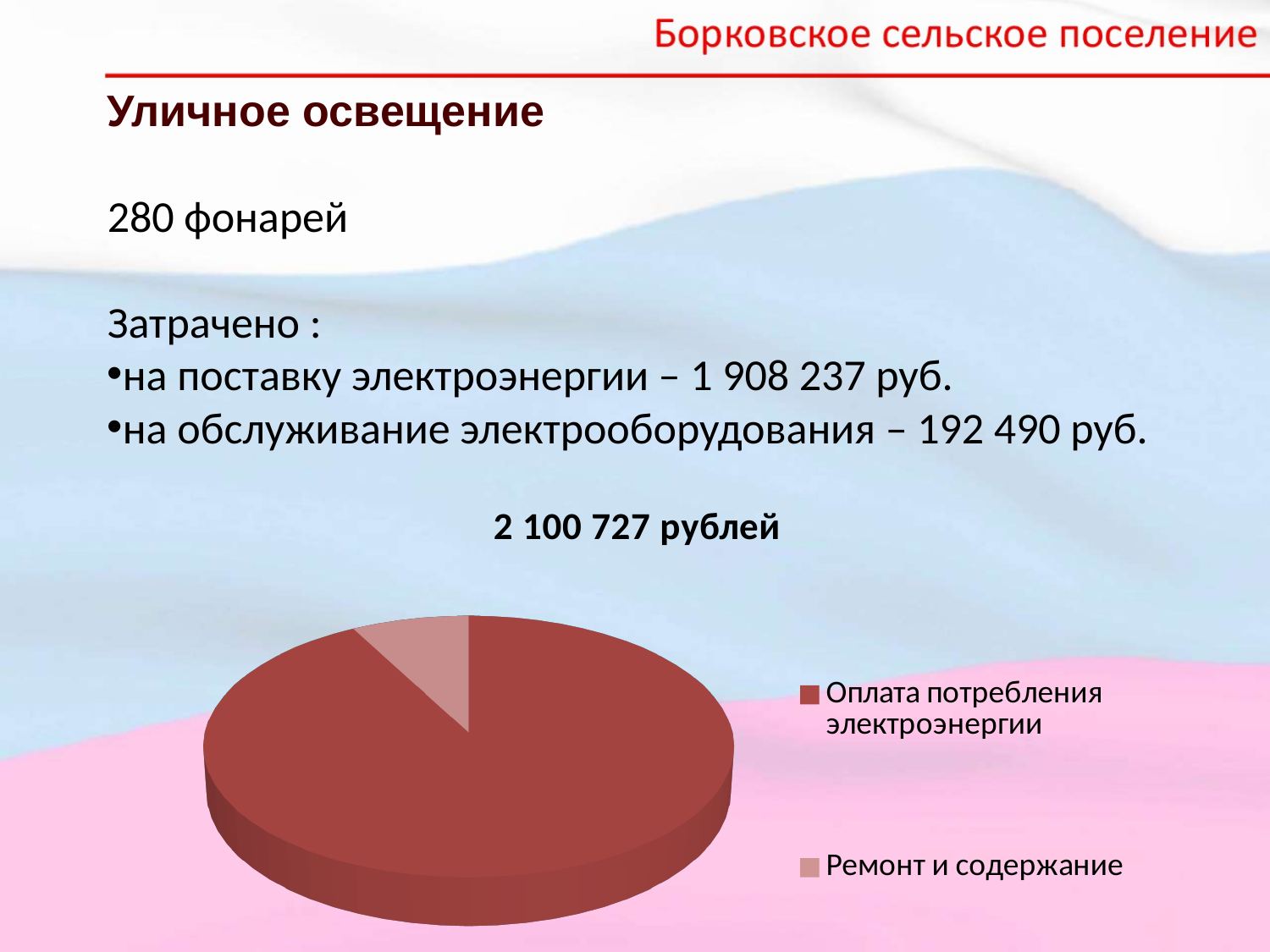
What kind of chart is shown on the slide? pie chart Which legend entry is shown in the lighter pink colour? Ремонт и содержание How many slices does the pie chart have? 2 How many entries does the legend of the pie chart list? 2 Which category takes the largest share of the pie chart? Оплата потребления электроэнергии Which category takes the smallest share of the pie chart? Ремонт и содержание What is the title of the pie chart? 2 100 727 рублей Which is larger in the pie chart: Оплата потребления электроэнергии or Ремонт и содержание? Оплата потребления электроэнергии